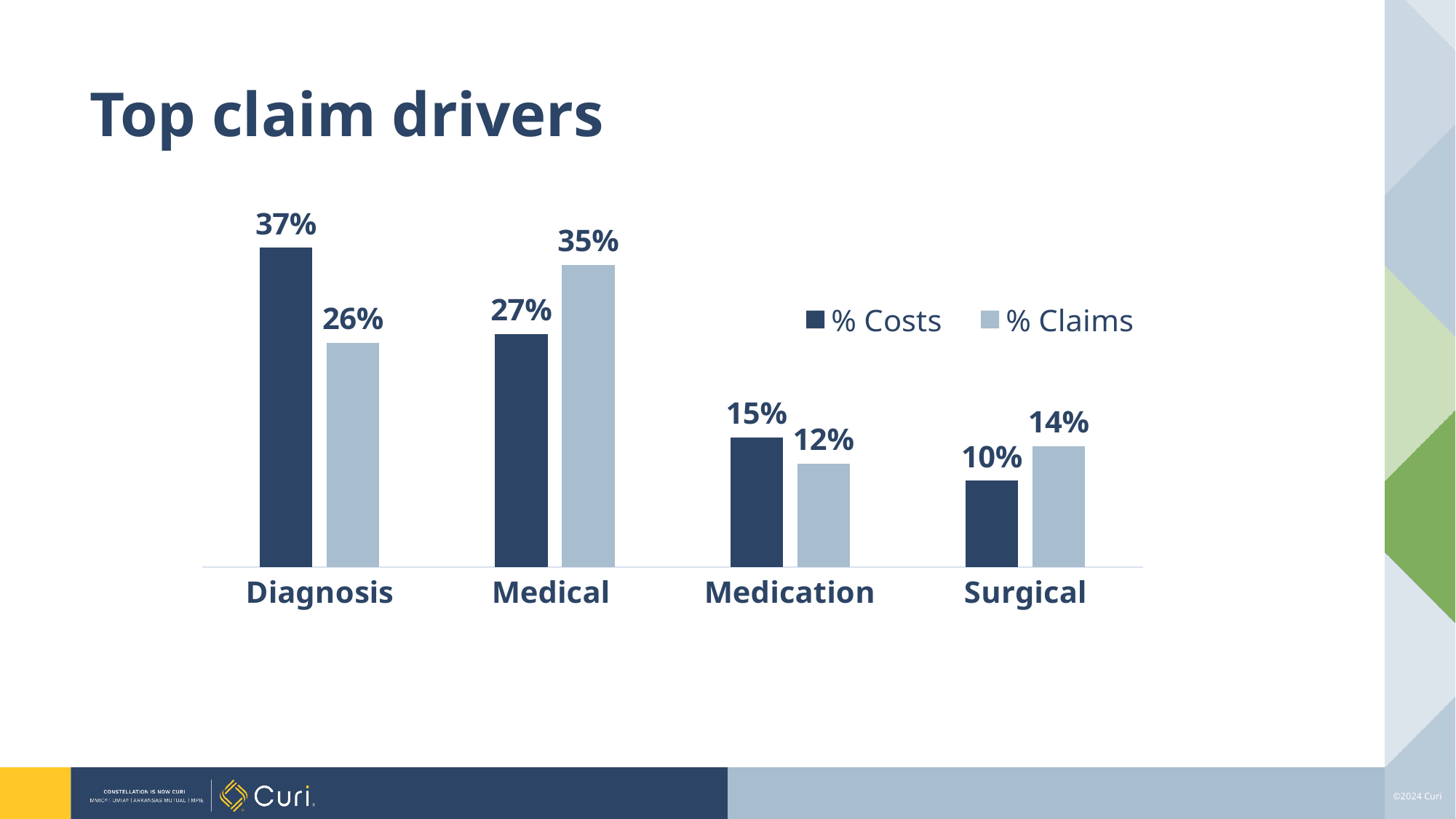
What is the title of the slide? Top claim drivers What is the % Claims value for Surgical? 14% What is the % Costs value for Medication? 15% Which category has the lowest % Claims value? Medication What kind of chart is shown on the slide? Bar chart What is the % Costs value for Diagnosis? 37% Which category has the highest % Costs value? Diagnosis How many series does the legend list? 2 What is the % Claims value for Medical? 35% What is the difference between the % Costs and % Claims values for Diagnosis? 11% Which is larger for Medical: % Costs or % Claims? % Claims How many categories are shown on the x axis? 4